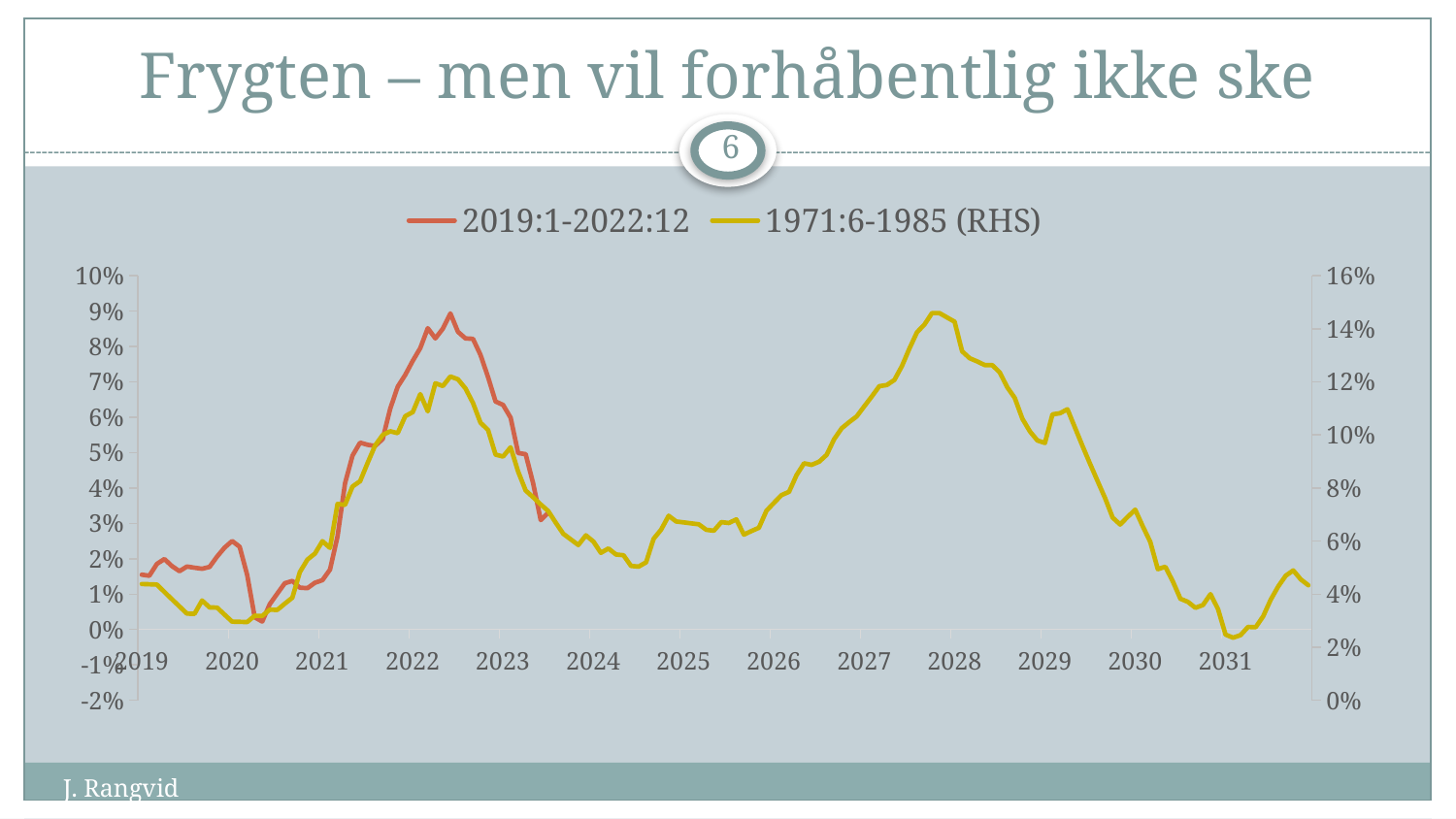
Is the lowest value of the 1971:6-1985 (RHS) series (around 2031) greater or less than 4% on the right-hand axis? less What kind of chart is shown on the slide? line chart Does the 2019:1-2022:12 series rise or fall between 2021 and mid-2022? rise For the 2019:1-2022:12 series, is the value higher in 2020 or in 2022? 2022 Which series is plotted against the right-hand axis? 1971:6-1985 (RHS) Is the value of the 2019:1-2022:12 series at the start of 2019 greater or less than 3%? less Does the 1971:6-1985 (RHS) series rise or fall between 2028 and 2031? fall Is the peak value of the 1971:6-1985 (RHS) series (around 2028) greater or less than 12% on the right-hand axis? greater How many series does the legend list? 2 What is the highest value shown on the right-hand axis? 16% Does the 1971:6-1985 (RHS) series reach its peak closer to 2028 or to 2030? 2028